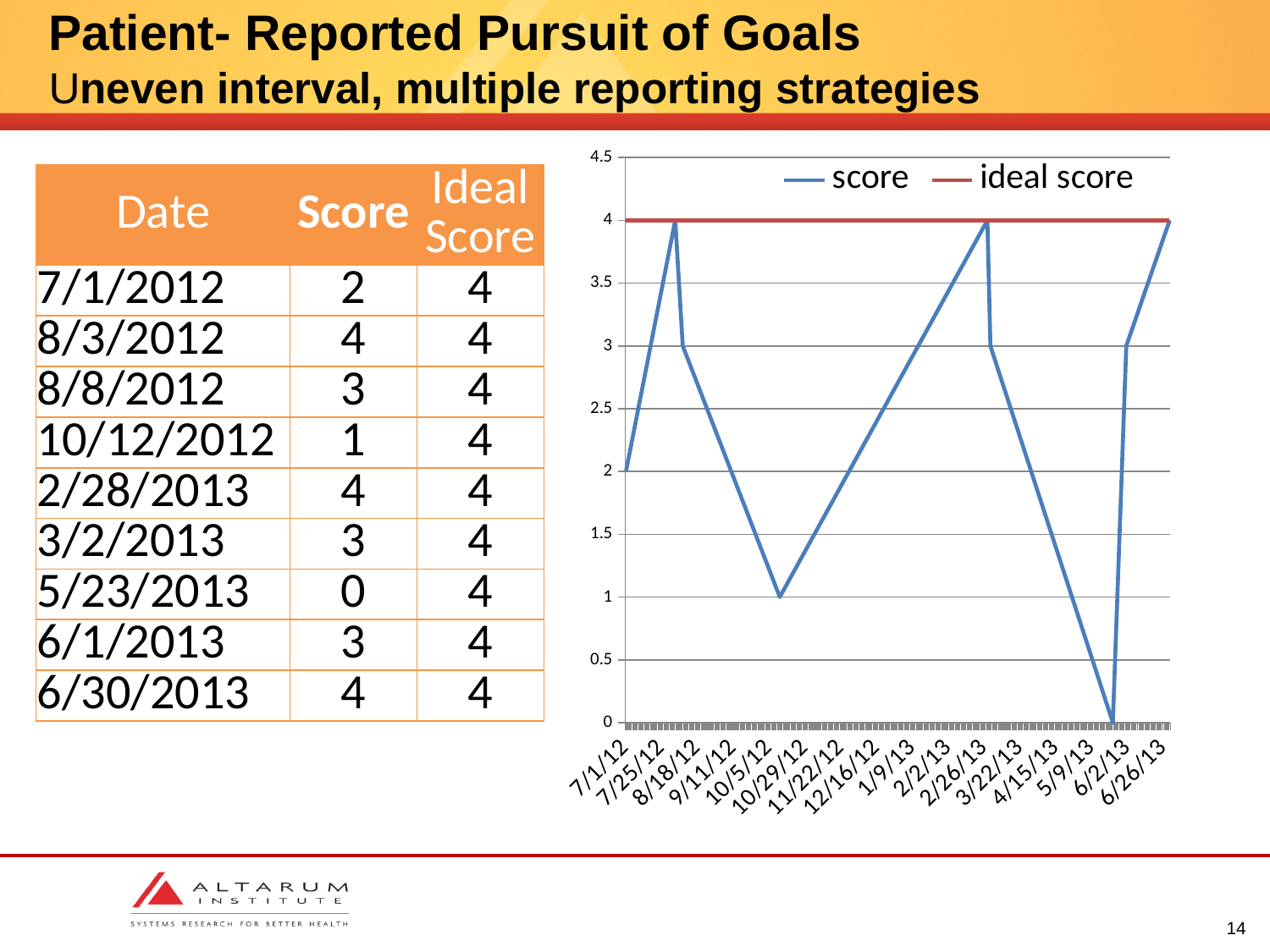
What kind of chart is shown on the slide? line chart What is the score on 7/1/2012? 2 On which date is the score lowest? 5/23/2013 How many dates have a score recorded in the table? 9 What is the ideal score value shown across all dates? 4 How many series does the chart legend list? 2 What are the two series named in the chart legend? score and ideal score What is the score on 10/12/2012? 1 What is the difference between the ideal score and the score on 10/12/2012? 3 Which is larger, the score on 8/3/2012 or the score on 8/8/2012? 8/3/2012 Does the score rise or fall between 6/1/2013 and 6/30/2013? rise What is the score on 5/23/2013? 0